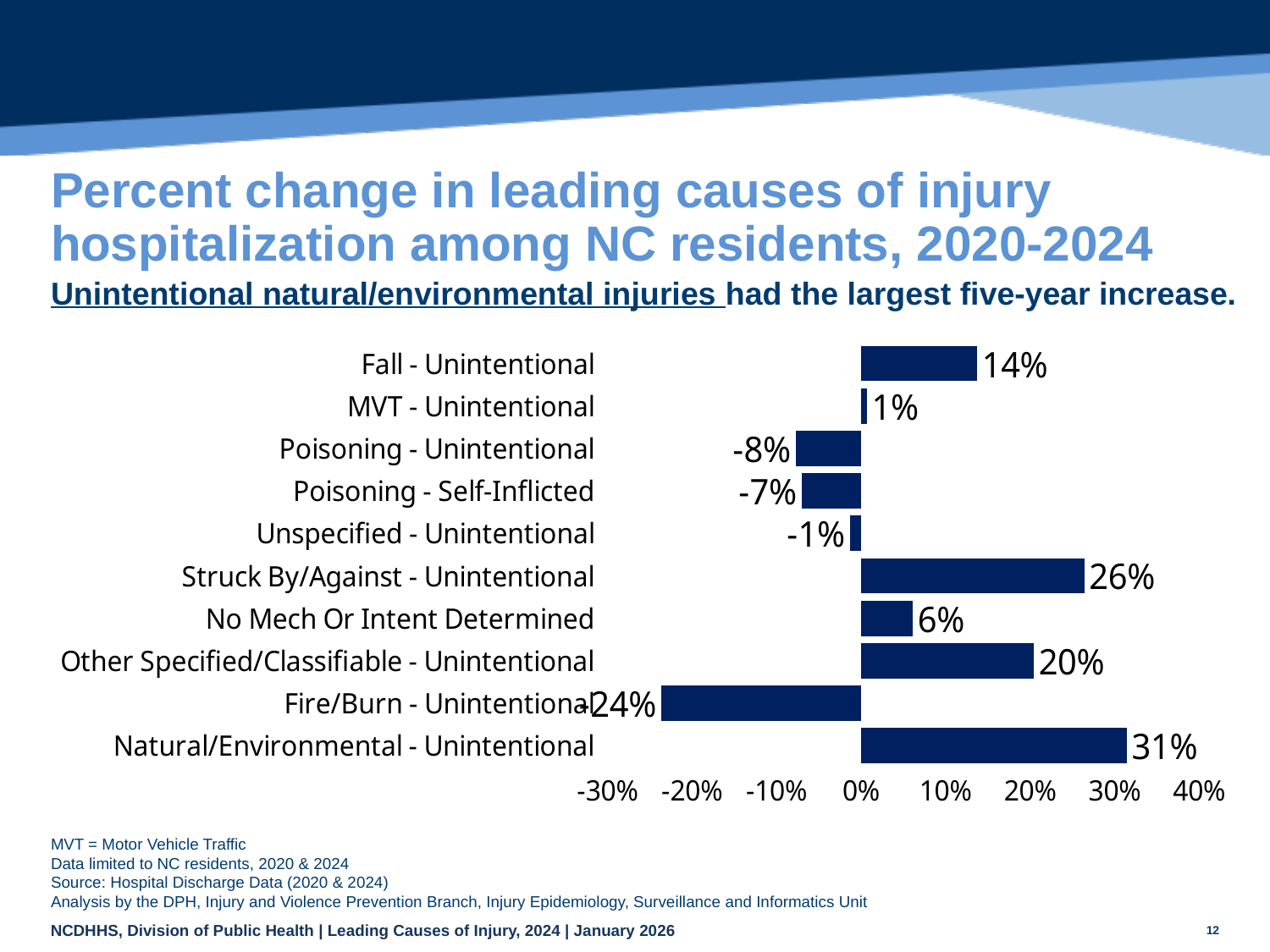
What is the difference between the percent change for Natural/Environmental - Unintentional and Other Specified/Classifiable - Unintentional? 11% Which category has the highest percent change? Natural/Environmental - Unintentional What is the percent change for Fire/Burn - Unintentional? -24% Is the value for Struck By/Against - Unintentional greater or less than 20%? greater What kind of chart is shown on the slide? Bar chart How many categories are shown in the chart? 10 What is the percent change for Poisoning - Self-Inflicted? -7% What is the percent change for Struck By/Against - Unintentional? 26% Which has a larger percent change, Fall - Unintentional or No Mech Or Intent Determined? Fall - Unintentional How many categories show a negative percent change? 4 Which category has the lowest percent change? Fire/Burn - Unintentional What is the percent change for Fall - Unintentional? 14%